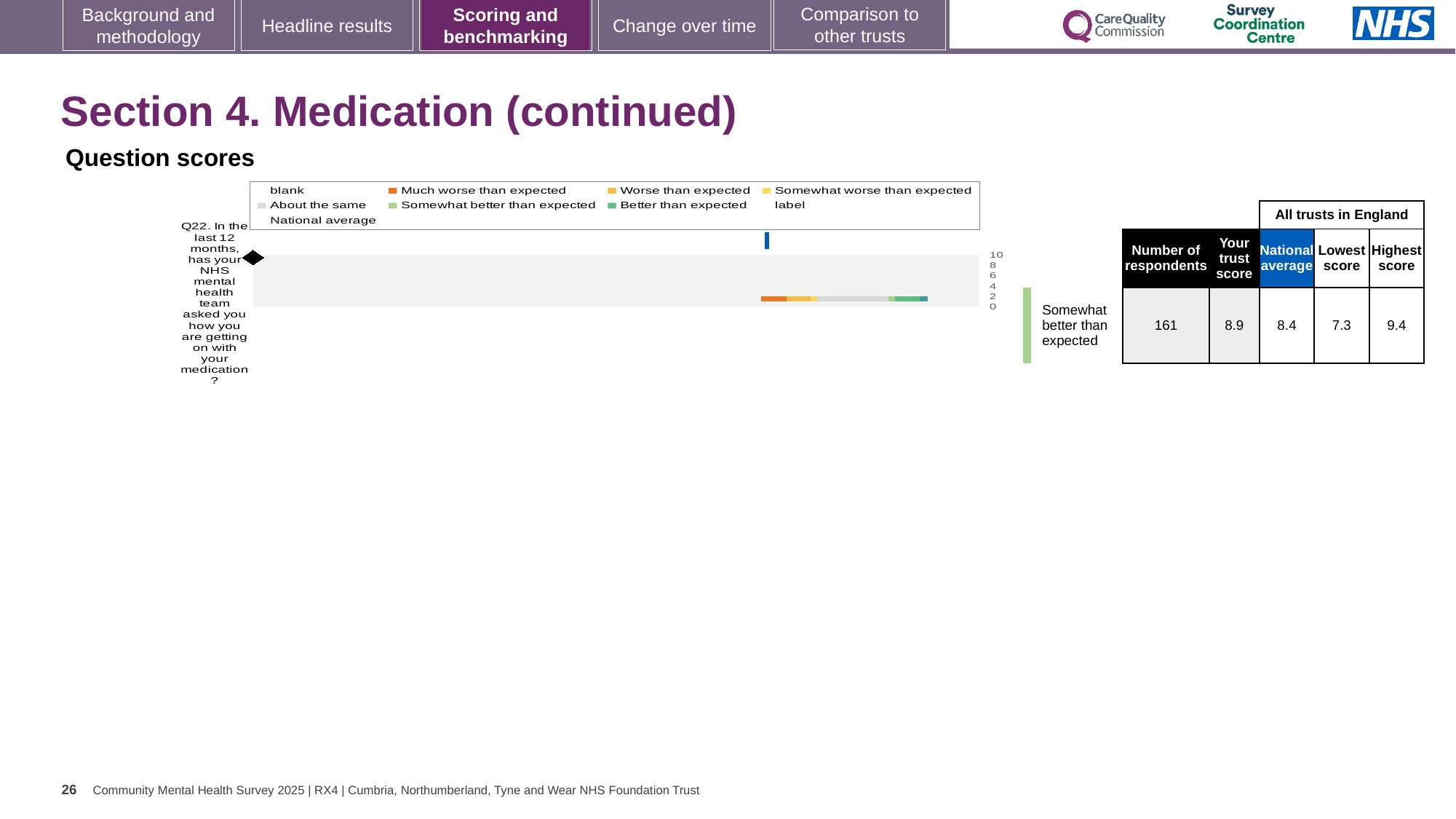
What kind of chart is shown under 'Question scores'? bar chart How many questions (categories) are plotted on the chart? 1 What colour does the legend use for 'Much worse than expected'? orange What is the highest tick value shown on the chart's axis? 10 Which question is plotted on the chart? Q22. In the last 12 months, has your NHS mental health team asked you how you are getting on with your medication? How many entries does the chart legend list? 9